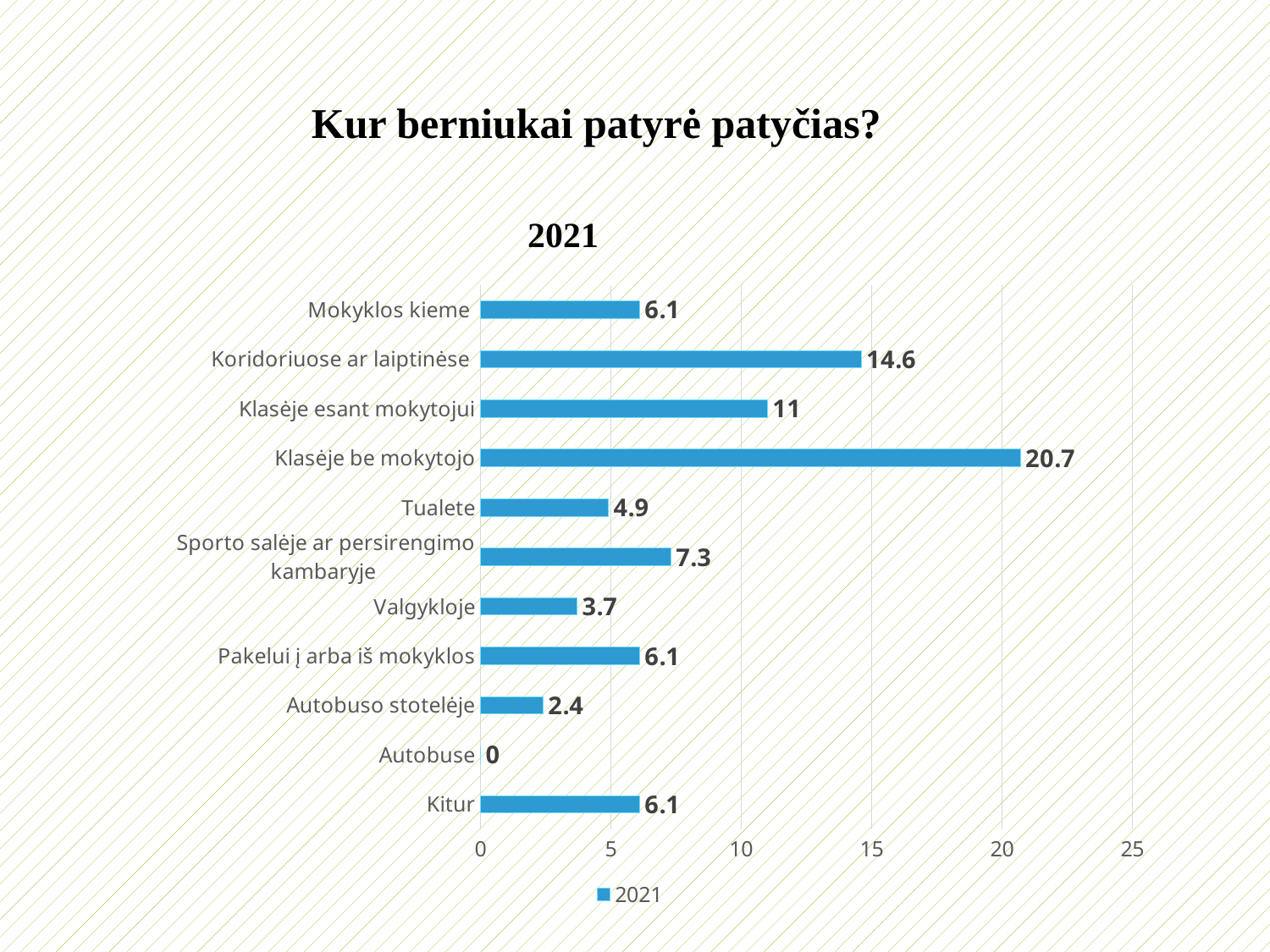
What is the title of the chart? 2021 Which is larger, the value for Tualete or the value for Valgykloje? Tualete Is the value for Sporto salėje ar persirengimo kambaryje greater or less than 5? greater What is the value for Koridoriuose ar laiptinėse? 14.6 Which category has the lowest value? Autobuse What is the value for Klasėje be mokytojo? 20.7 How many series does the legend list? 1 Which category has the highest value? Klasėje be mokytojo What is the difference between the values for Klasėje be mokytojo and Klasėje esant mokytojui? 9.7 What kind of chart is shown on the slide? bar chart How many categories are shown in the chart? 11 What is the value for Autobuso stotelėje? 2.4